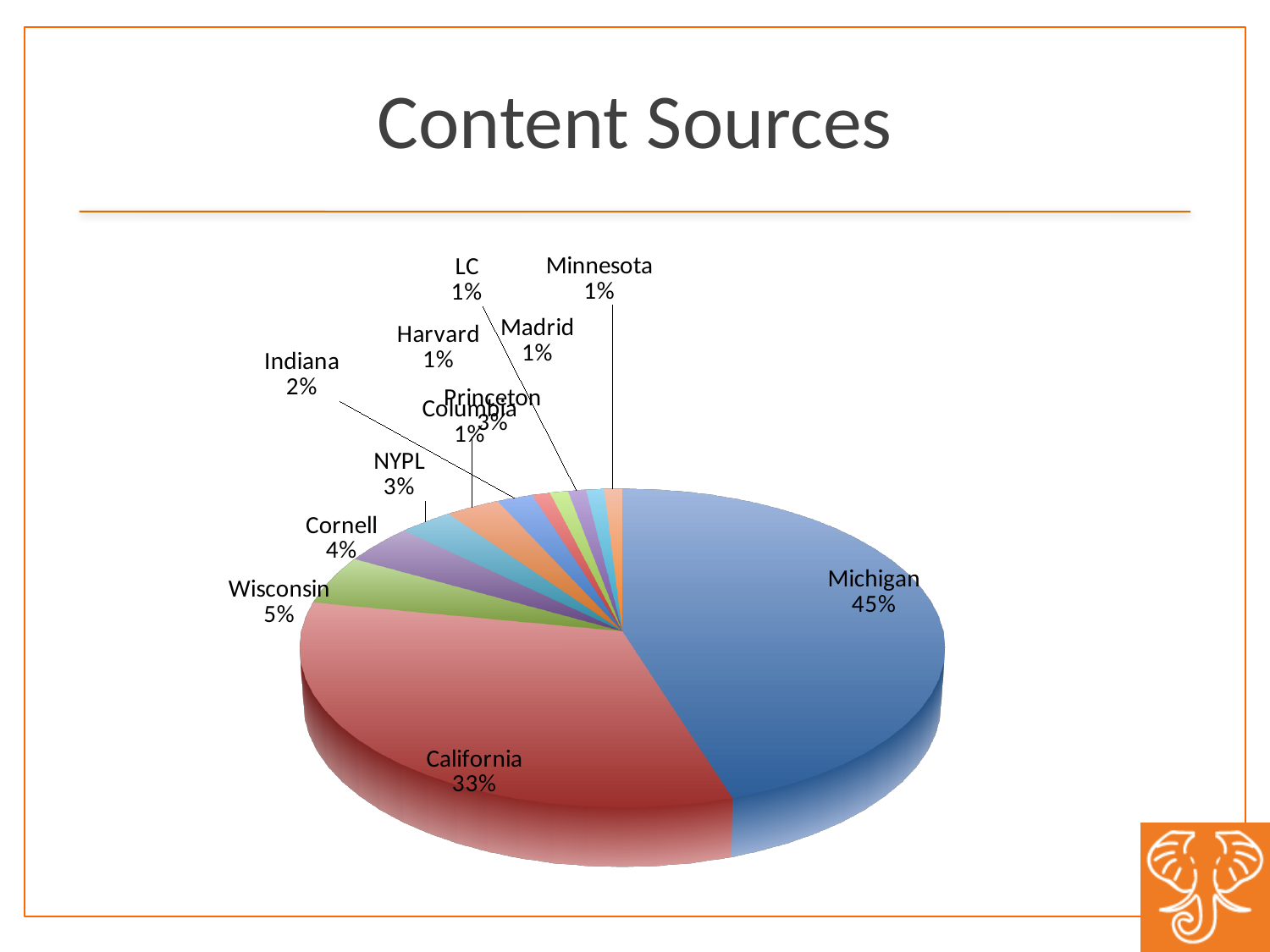
What is the value shown for Wisconsin? 5% What is the value shown for Minnesota? 1% What is the value shown for Indiana? 2% What share of the pie does Michigan account for? 45% What share of the pie does California account for? 33% What kind of chart is shown on the slide? Pie chart Which has a larger share, Wisconsin or Cornell? Wisconsin What is the difference between the shares of Michigan and California? 12% Which content source has the largest share of the pie? Michigan What is the value shown for Cornell? 4% What is the value shown for NYPL? 3% What is the title of the chart on the slide? Content Sources